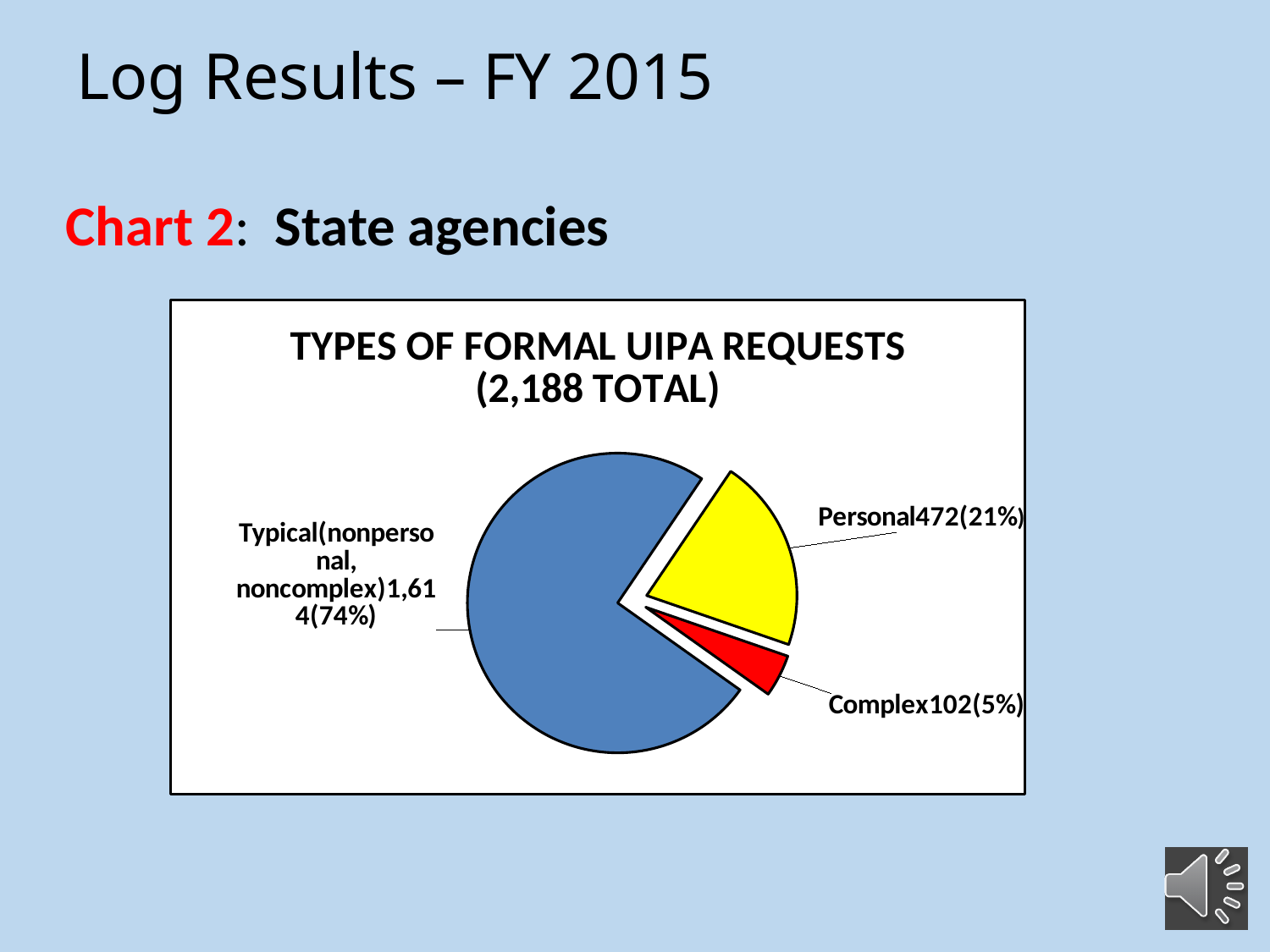
Which category has the largest slice of the pie? Typical (nonpersonal, noncomplex) How many Personal requests are shown in the pie chart? 472 What is the difference between the number of Personal requests and Complex requests? 370 What kind of chart is shown on the slide? pie chart What share of the pie do Personal requests make up? 21% Which category has the smallest slice of the pie? Complex What colour is the Complex slice in the pie chart? red What is the total number of formal UIPA requests given in the chart title? 2,188 How many slices does the pie chart have? 3 What share of the pie do Complex requests make up? 5% How many Complex requests are shown in the pie chart? 102 How many Typical (nonpersonal, noncomplex) requests are shown in the pie chart? 1,614